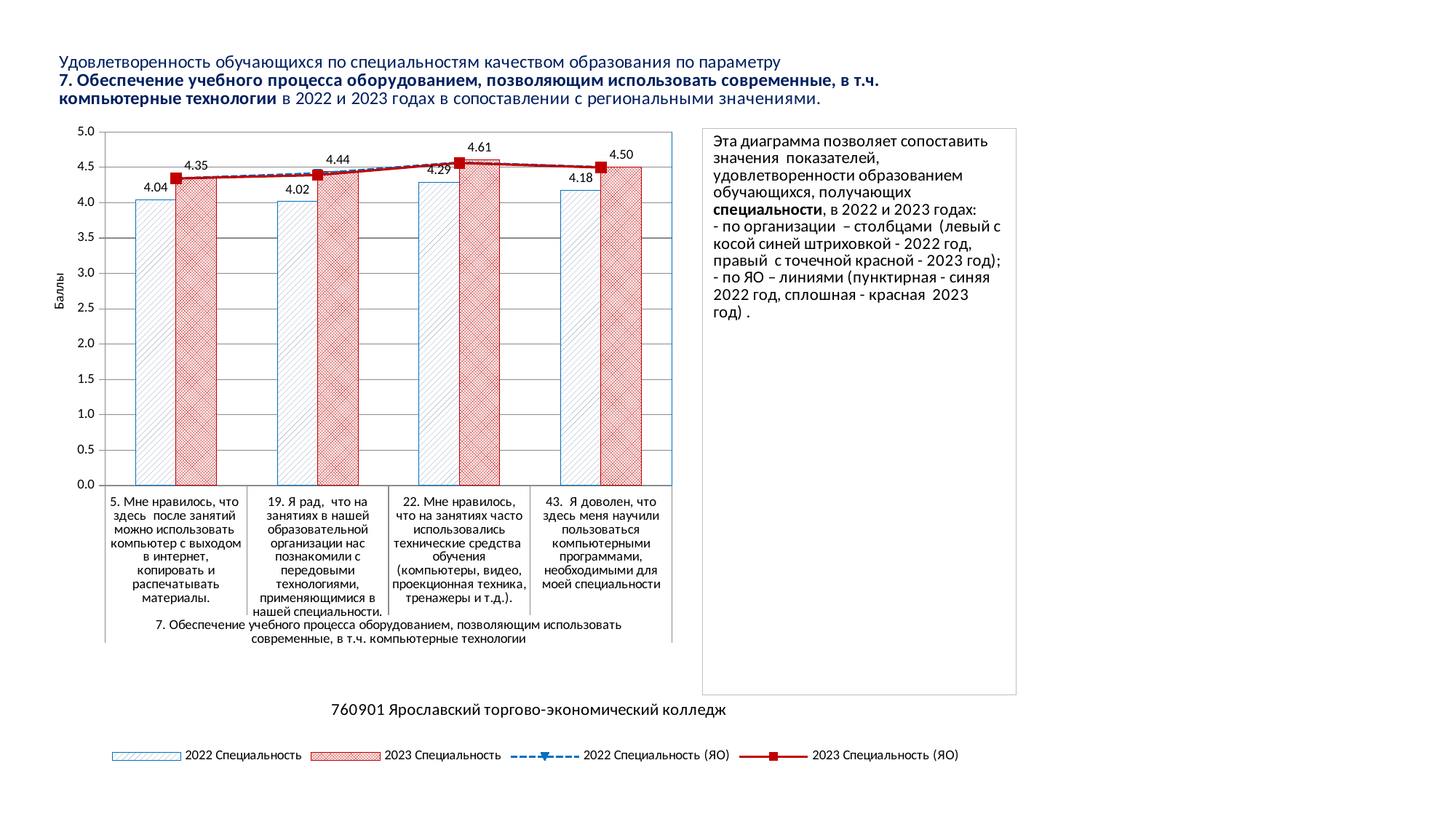
Which category has the lowest 2022 Специальность bar? 19. Я рад, что на занятиях в нашей образовательной организации нас познакомили с передовыми технологиями Is the 2022 Специальность value for category 22 greater or less than 4.0? greater How many categories are shown on the x axis of the chart? 4 What type of chart is shown on the slide? Combined bar and line chart Which category has the highest 2023 Специальность bar? 22. Мне нравилось, что на занятиях часто использовались технические средства обучения What is the label of the y axis? Баллы What is the value of the 2023 Специальность bar for category 22 ("Мне нравилось, что на занятиях часто использовались технические средства обучения...")? 4.61 What is the value of the 2023 Специальность bar for category 43 ("Я доволен, что здесь меня научили пользоваться компьютерными программами...")? 4.50 What is the value of the 2022 Специальность bar for category 5 ("Мне нравилось, что здесь после занятий можно использовать компьютер с выходом в интернет...")? 4.04 For category 43, which is larger: the 2022 Специальность bar or the 2023 Специальность bar? 2023 Специальность What is the difference between the 2023 and 2022 Специальность bars for category 19? 0.42 How many series does the legend list? 4